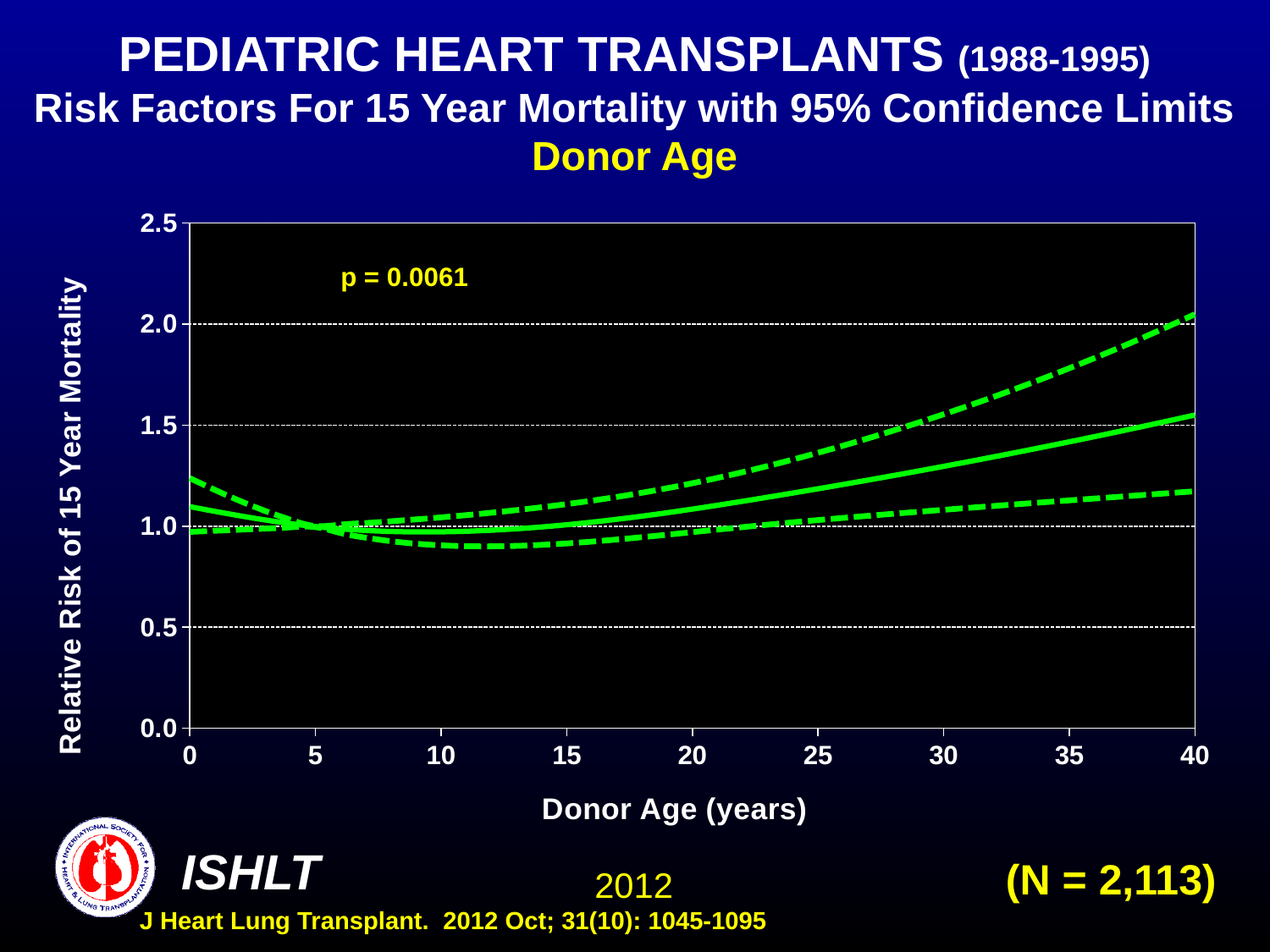
Is the upper confidence limit (upper dashed line) at donor age 40 greater or less than 1.5? greater Is the lower confidence limit (lower dashed line) at donor age 40 greater or less than 1.5? less What is the sample size (N) shown on the slide? 2,113 Is the lower confidence limit (lower dashed line) at donor age 10 greater or less than 1.0? less What kind of chart is shown on the slide? line chart How many lines are plotted on the chart? 3 Which is larger at donor age 40: the upper dashed confidence limit or the solid relative risk line? the upper dashed confidence limit Does the solid relative risk line rise or fall as donor age increases from 10 to 40 years? rise What is the p-value printed on the chart? p = 0.0061